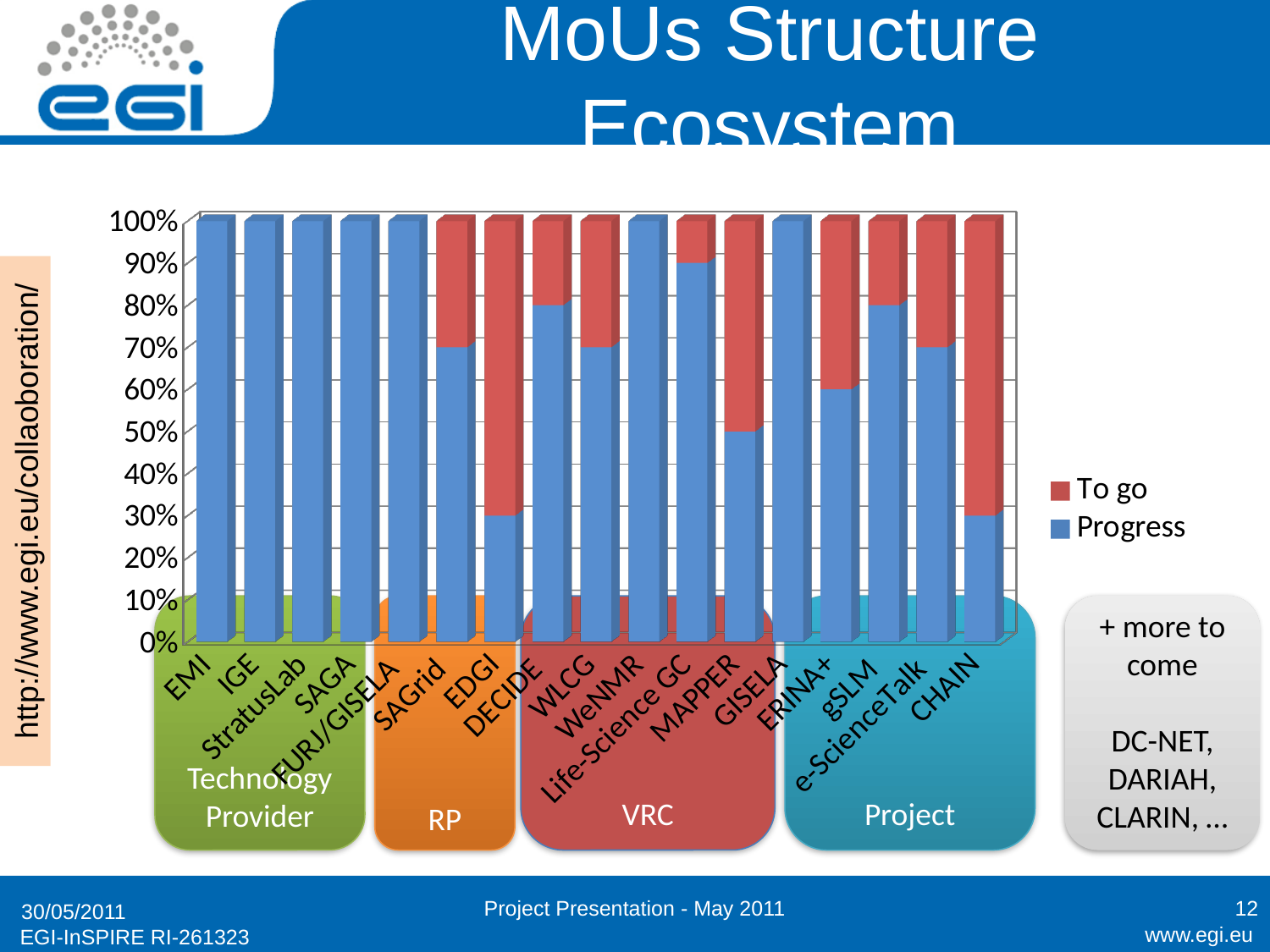
What is the Progress value for WeNMR? 100% How many categories (MoUs) are plotted along the x axis? 17 Which has a larger Progress value, CHAIN or gSLM? gSLM What kind of chart is shown on the slide? stacked bar chart What is the Progress value for EMI? 100% How many series does the legend list? 2 What are the two series named in the legend? To go, Progress Is the Progress value for EDGI greater or less than 50%? less Which has a larger Progress value, EDGI or MAPPER? MAPPER What colour represents the Progress series? blue Is the Progress value for ERINA+ greater or less than 80%? less Is the Progress value for Life-Science GC greater or less than 80%? greater